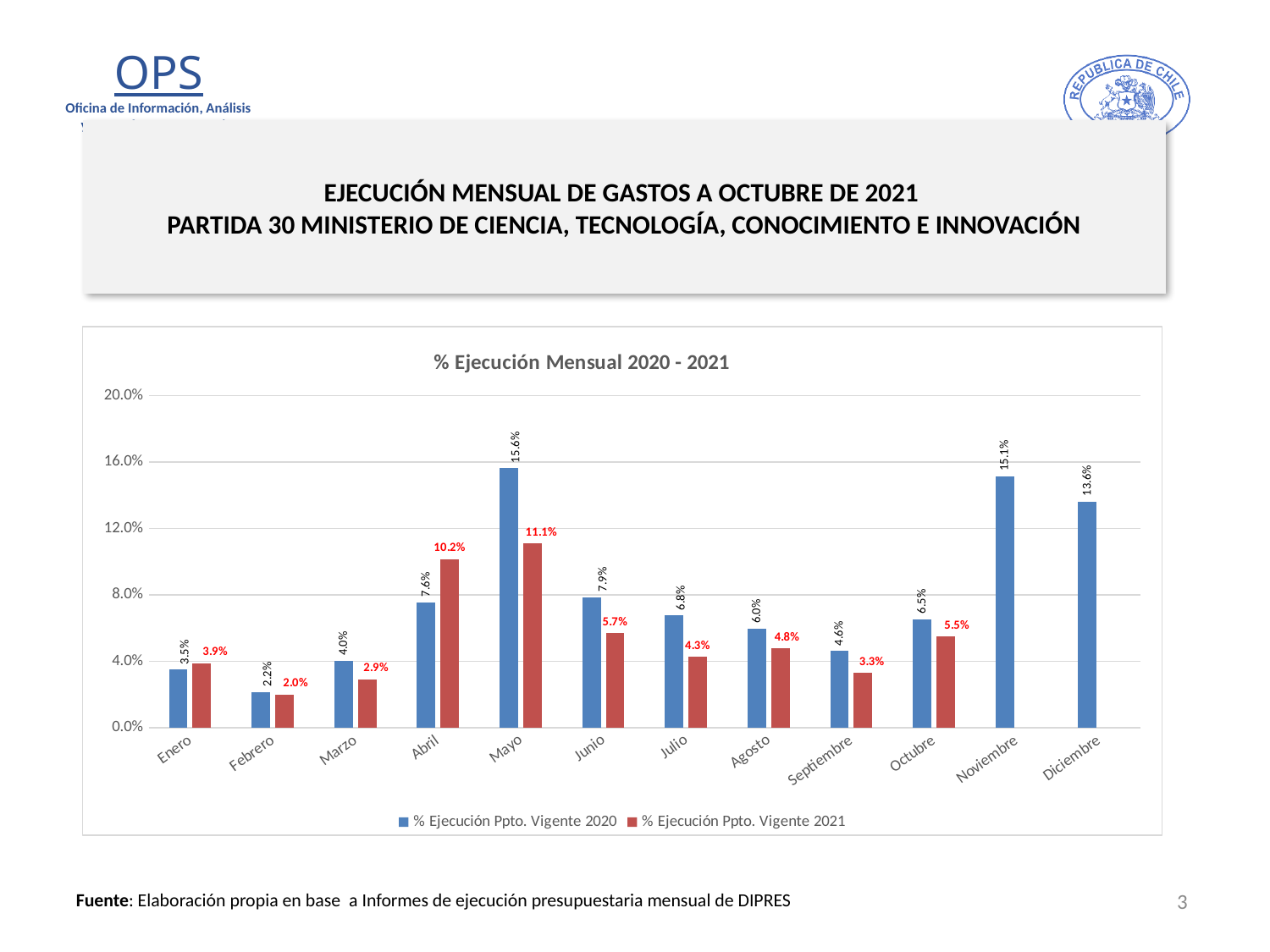
How many series does the legend list? 2 What is the value for Abril in the % Ejecución Ppto. Vigente 2021 series? 10.2% How many months are shown on the x axis? 12 What is the title of the chart? % Ejecución Mensual 2020 - 2021 Which month has the highest value in the % Ejecución Ppto. Vigente 2020 series? Mayo What kind of chart is shown? Bar chart What is the difference between the 2020 and 2021 values for Mayo? 4.5% Which is larger for Abril: the 2020 value or the 2021 value? 2021 value (10.2%) What is the value for Octubre in the % Ejecución Ppto. Vigente 2021 series? 5.5% Which months have no value for the % Ejecución Ppto. Vigente 2021 series? Noviembre and Diciembre Which month has the lowest value in the % Ejecución Ppto. Vigente 2021 series? Febrero What is the value for Mayo in the % Ejecución Ppto. Vigente 2020 series? 15.6%